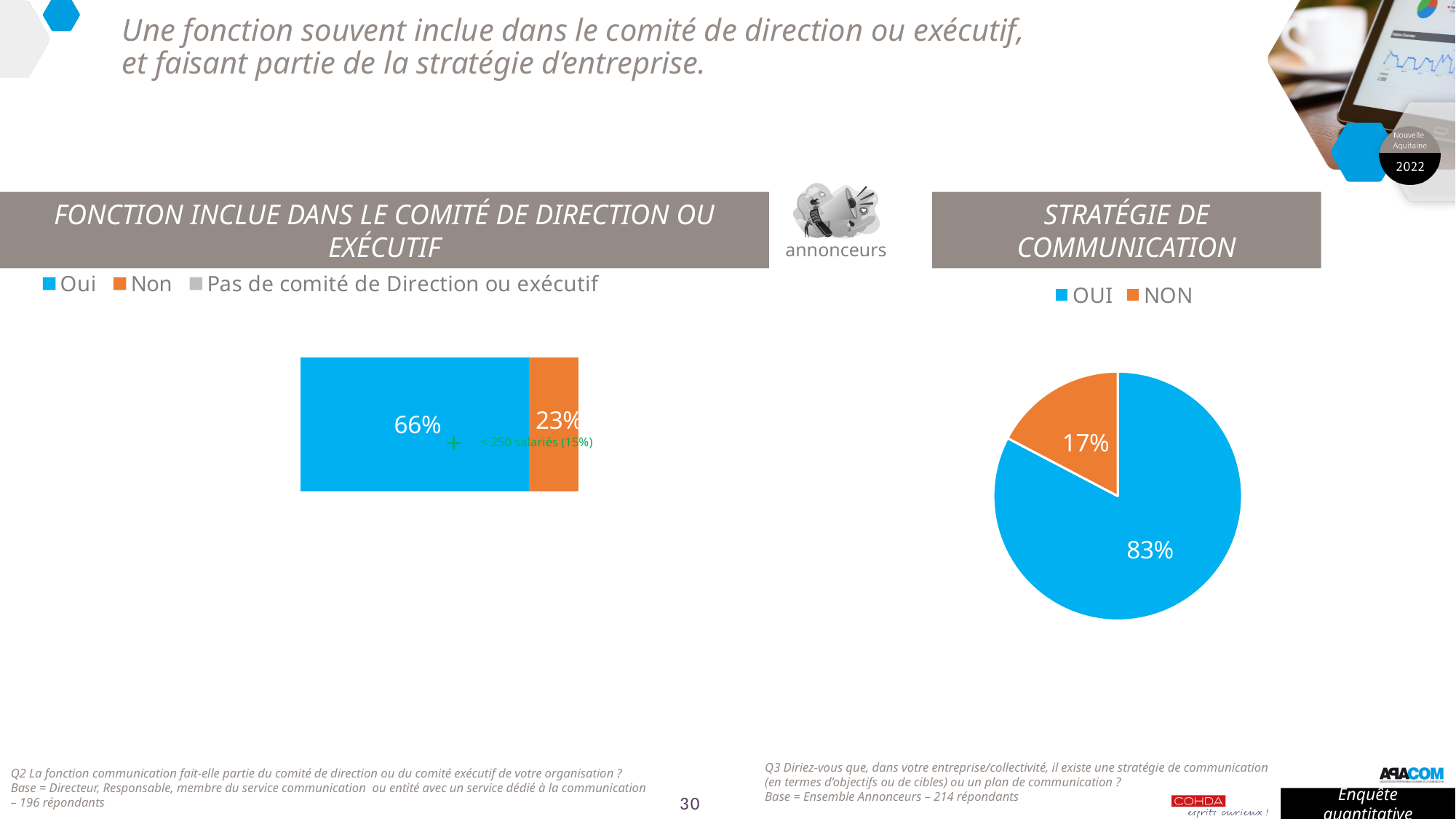
In the chart titled 'STRATÉGIE DE COMMUNICATION', how many series does the legend list? 2 What kind of chart is the one titled 'FONCTION INCLUE DANS LE COMITÉ DE DIRECTION OU EXÉCUTIF'? Bar chart In the chart titled 'FONCTION INCLUE DANS LE COMITÉ DE DIRECTION OU EXÉCUTIF', what is the value for 'Non'? 23% In the chart titled 'FONCTION INCLUE DANS LE COMITÉ DE DIRECTION OU EXÉCUTIF', what is the value for 'Oui'? 66% What kind of chart is the one titled 'STRATÉGIE DE COMMUNICATION'? Pie chart In the chart titled 'STRATÉGIE DE COMMUNICATION', what is the share for 'NON'? 17% In the chart titled 'FONCTION INCLUE DANS LE COMITÉ DE DIRECTION OU EXÉCUTIF', which is larger, 'Oui' or 'Non'? Oui In the chart titled 'STRATÉGIE DE COMMUNICATION', which slice is the largest? OUI In the chart titled 'STRATÉGIE DE COMMUNICATION', what is the share for 'OUI'? 83% In the chart titled 'STRATÉGIE DE COMMUNICATION', what is the difference between the 'OUI' and 'NON' shares? 66% In the chart titled 'FONCTION INCLUE DANS LE COMITÉ DE DIRECTION OU EXÉCUTIF', how many series does the legend list? 3 In the chart titled 'FONCTION INCLUE DANS LE COMITÉ DE DIRECTION OU EXÉCUTIF', what is the difference between the 'Oui' and 'Non' values? 43%